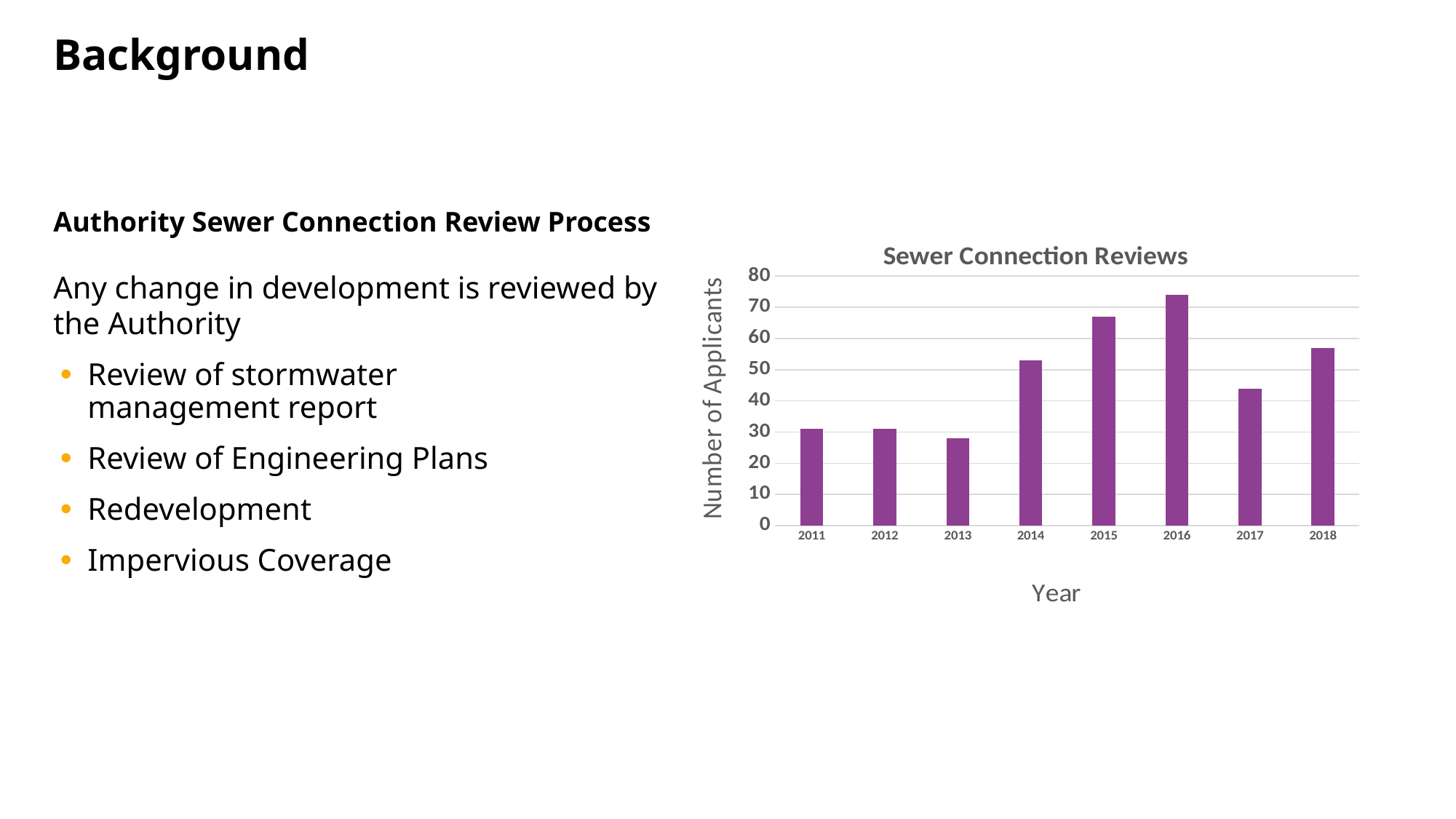
Is the value for 2013 greater or less than 30? less Is the value for 2017 greater or less than 50? less What is the label of the y axis? Number of Applicants What is the title of the chart? Sewer Connection Reviews Which year has more applicants, 2016 or 2018? 2016 Is the value for 2016 greater or less than 70? greater What kind of chart is shown on the slide? bar chart How many years are shown on the x axis of the chart? 8 Which year has more applicants, 2015 or 2017? 2015 Which year has the highest number of applicants? 2016